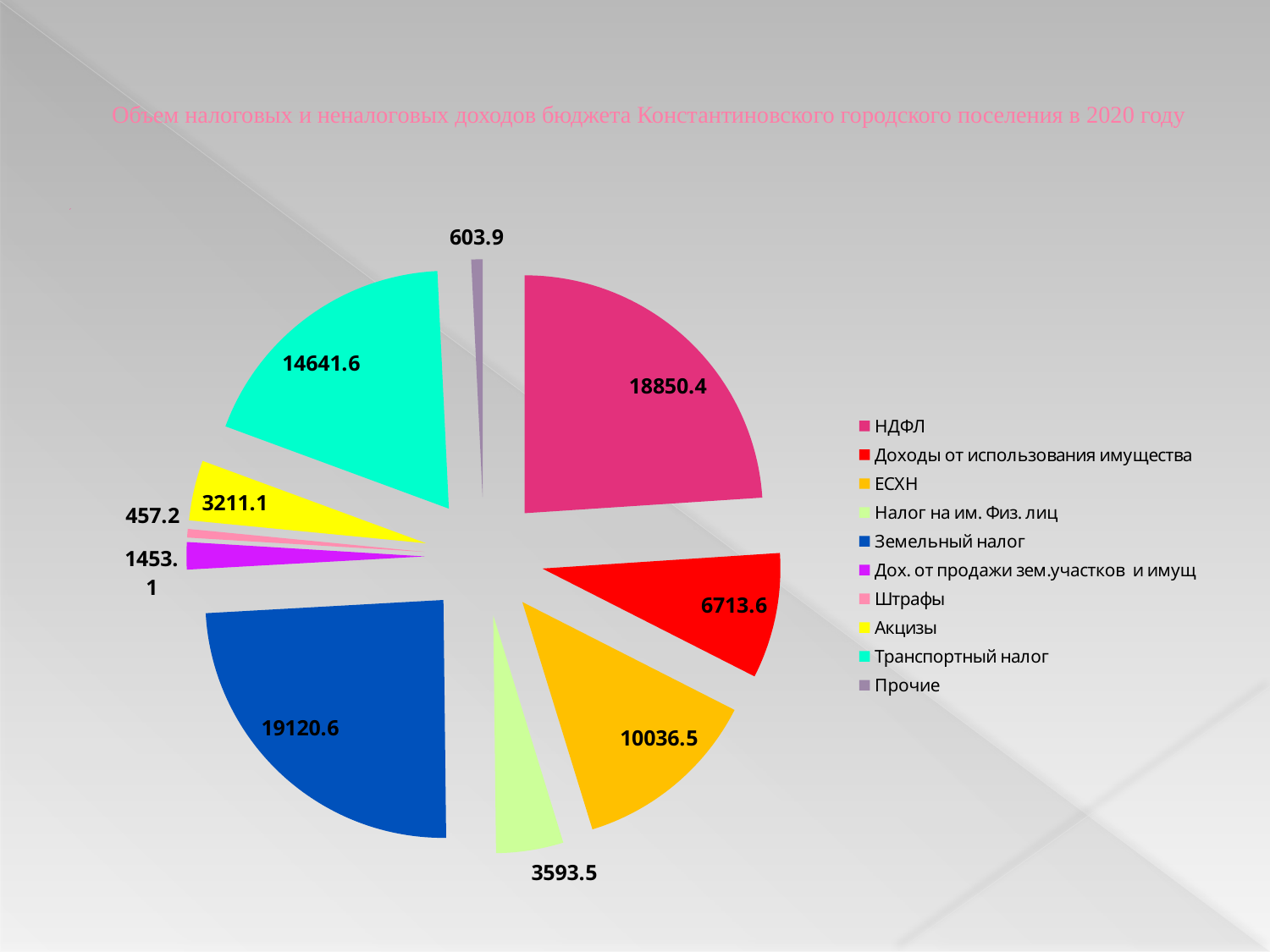
What is the value for Транспортный налог? 14641.6 Which category has the smallest value? Штрафы Which is larger: ЕСХН or Доходы от использования имущества? ЕСХН What is the value for Прочие? 603.9 What is the value for НДФЛ? 18850.4 What type of chart is shown on the slide? pie chart What is the value for Штрафы? 457.2 How many categories does the legend list? 10 Which category has the largest value? Земельный налог What is the value for Земельный налог? 19120.6 What is the difference between Транспортный налог and ЕСХН? 4605.1 What is the difference between Земельный налог and НДФЛ? 270.2